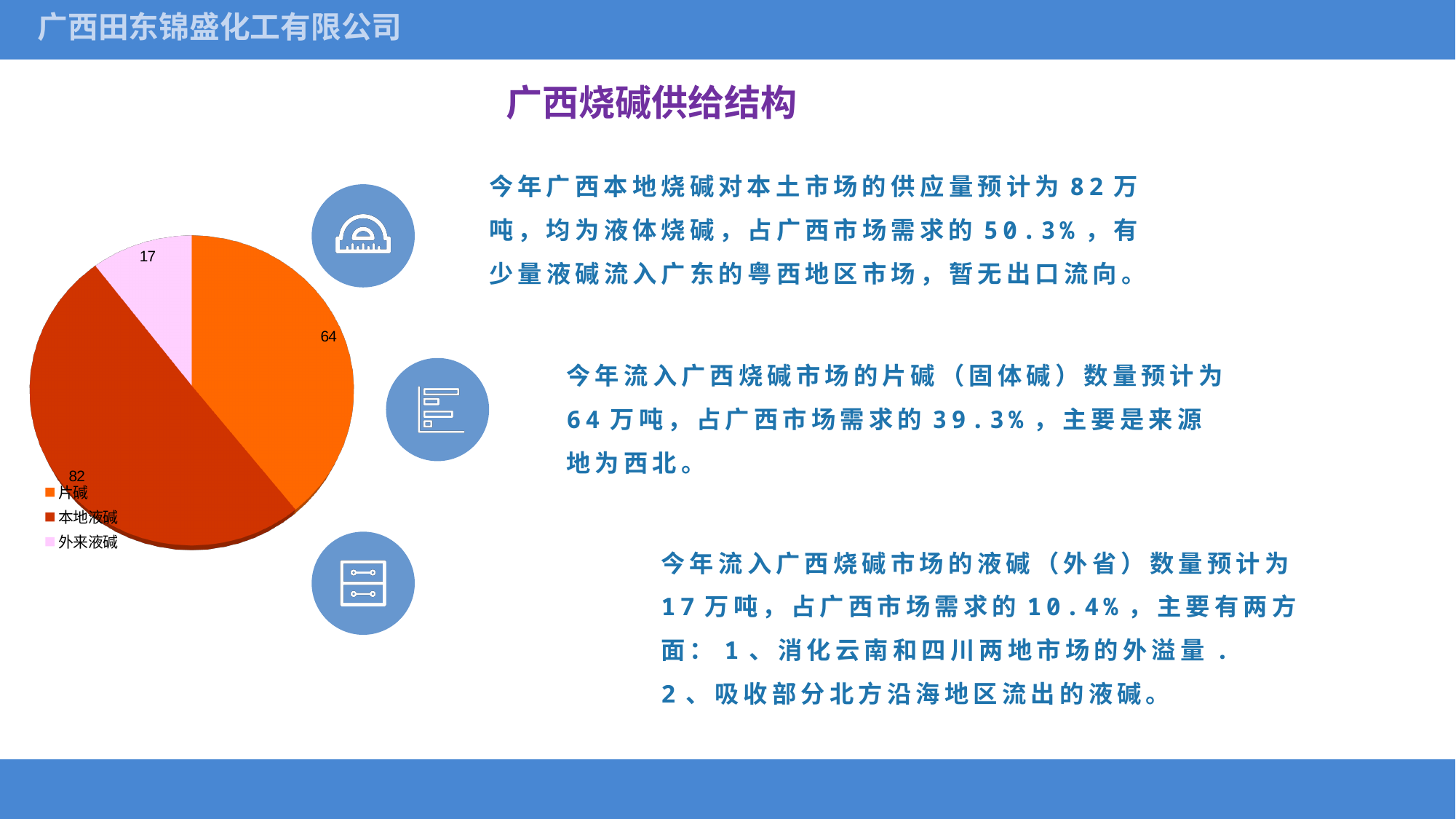
What is the difference between the values for 片碱 and 外来液碱? 47 What is the difference between the values for 本地液碱 and 片碱? 18 What is the value for 片碱 in the pie chart? 64 What share of the pie does 本地液碱 represent? 50.3% Which category has the largest slice in the pie chart? 本地液碱 What is the value for 本地液碱 in the pie chart? 82 Which is larger, the value for 片碱 or the value for 外来液碱? 片碱 What is the value for 外来液碱 in the pie chart? 17 Which colour represents 外来液碱 in the pie chart legend? pink How many slices does the pie chart have? 3 What kind of chart is shown on the slide? pie chart Which category has the smallest slice in the pie chart? 外来液碱